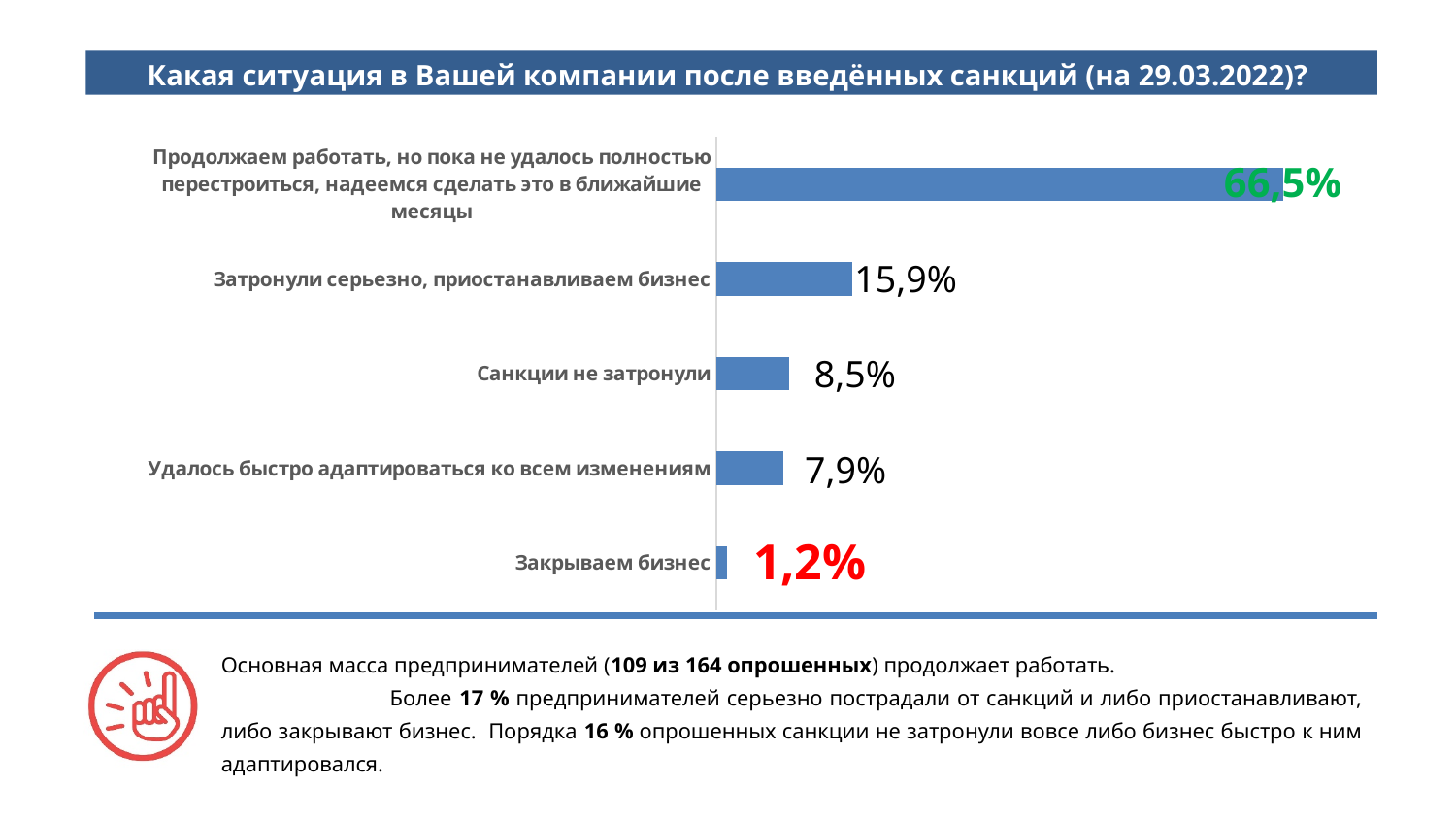
What is the difference between the values for «Удалось быстро адаптироваться ко всем изменениям» and «Закрываем бизнес»? 6,7% What is the title of the chart? Какая ситуация в Вашей компании после введённых санкций (на 29.03.2022)? What value is shown for «Затронули серьезно, приостанавливаем бизнес»? 15,9% Which category has the highest value? Продолжаем работать, но пока не удалось полностью перестроиться, надеемся сделать это в ближайшие месяцы What value is shown for «Санкции не затронули»? 8,5% How many categories are shown in the chart? 5 What is the difference between the values for «Затронули серьезно, приостанавливаем бизнес» and «Санкции не затронули»? 7,4% What type of chart is shown on the slide? Bar chart What value is shown for «Закрываем бизнес»? 1,2% Which is larger: the value for «Санкции не затронули» or for «Удалось быстро адаптироваться ко всем изменениям»? Санкции не затронули Which category has the lowest value? Закрываем бизнес What value is shown for «Удалось быстро адаптироваться ко всем изменениям»? 7,9%